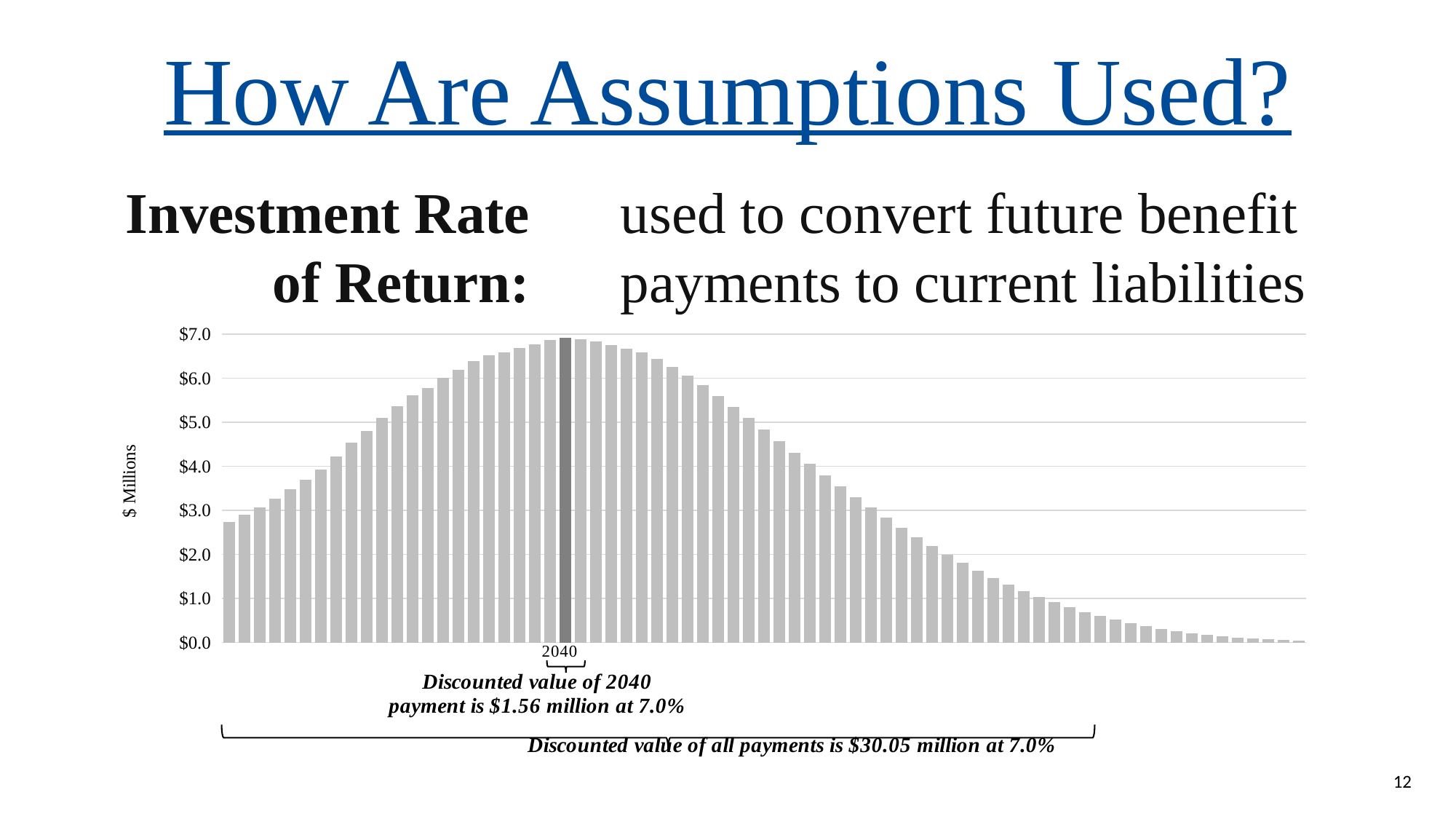
What discount rate is used in the annotations on the chart? 7.0% According to the annotation, what is the discounted value of all payments at 7.0%? $30.05 million Do the bar values rise or fall moving from the left edge of the chart toward 2040? rise What is the label on the vertical axis of the chart? $ Millions According to the annotation, what is the discounted value of the 2040 payment at 7.0%? $1.56 million Which year is highlighted with a darker bar on the chart? 2040 Is the value of the 2040 bar greater or less than $6.0 million? greater Is the value of the leftmost bar greater or less than $3.0 million? less What kind of chart is shown on the slide? bar chart Is the value of the rightmost bar greater or less than $1.0 million? less What is the highest tick value shown on the vertical axis? $7.0 Do the bar values rise or fall moving from 2040 toward the right edge of the chart? fall